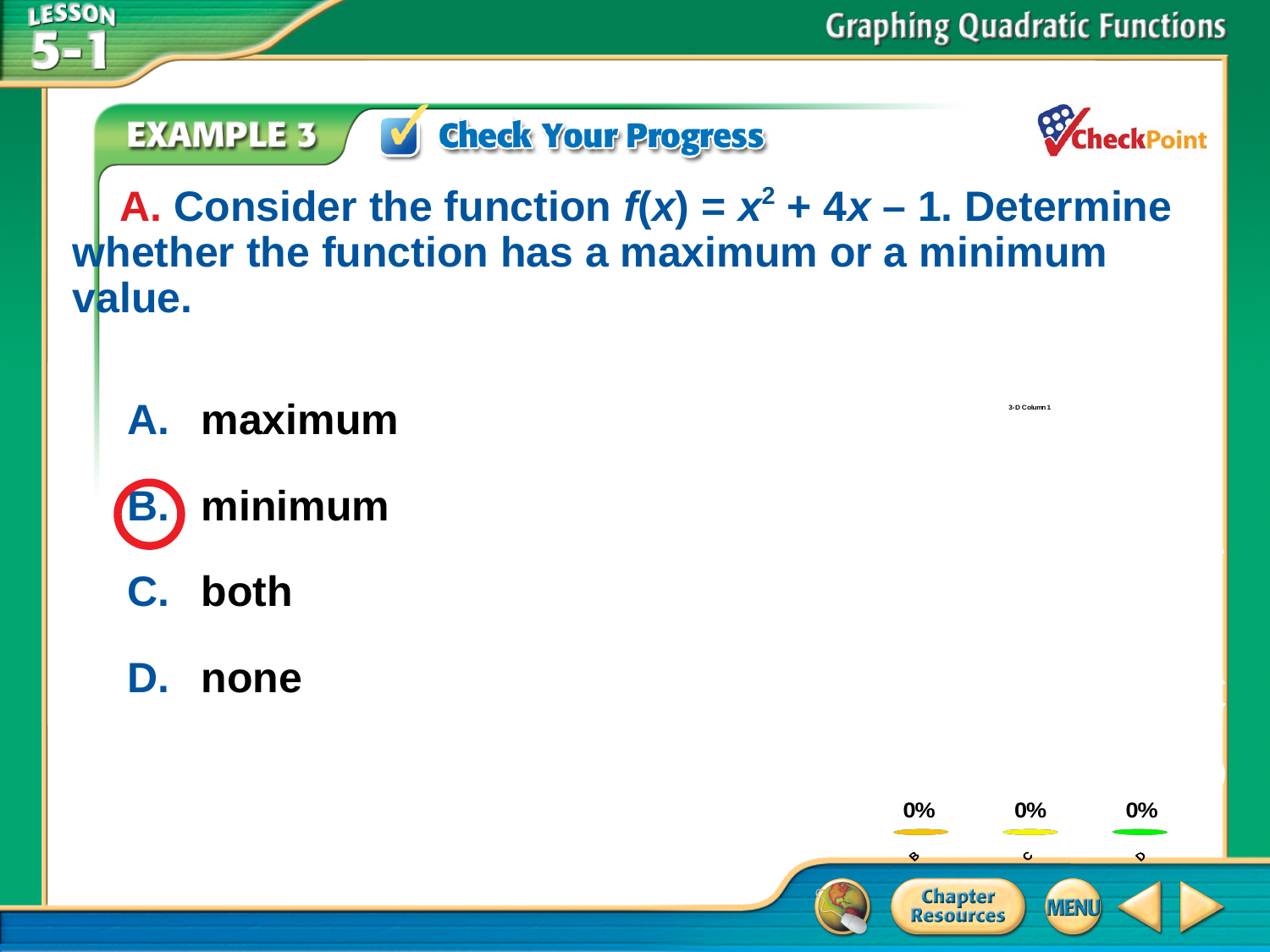
What value is shown for category C in the chart at the bottom right of the slide? 0% Is the value for category B in the bottom-right chart greater than 0%? no What value is shown for category D in the chart at the bottom right of the slide? 0% What kind of chart is shown at the bottom right of the slide? bar chart What value is shown for category B in the chart at the bottom right of the slide? 0% What is the title printed above the chart at the bottom right of the slide? 3-D Column 1